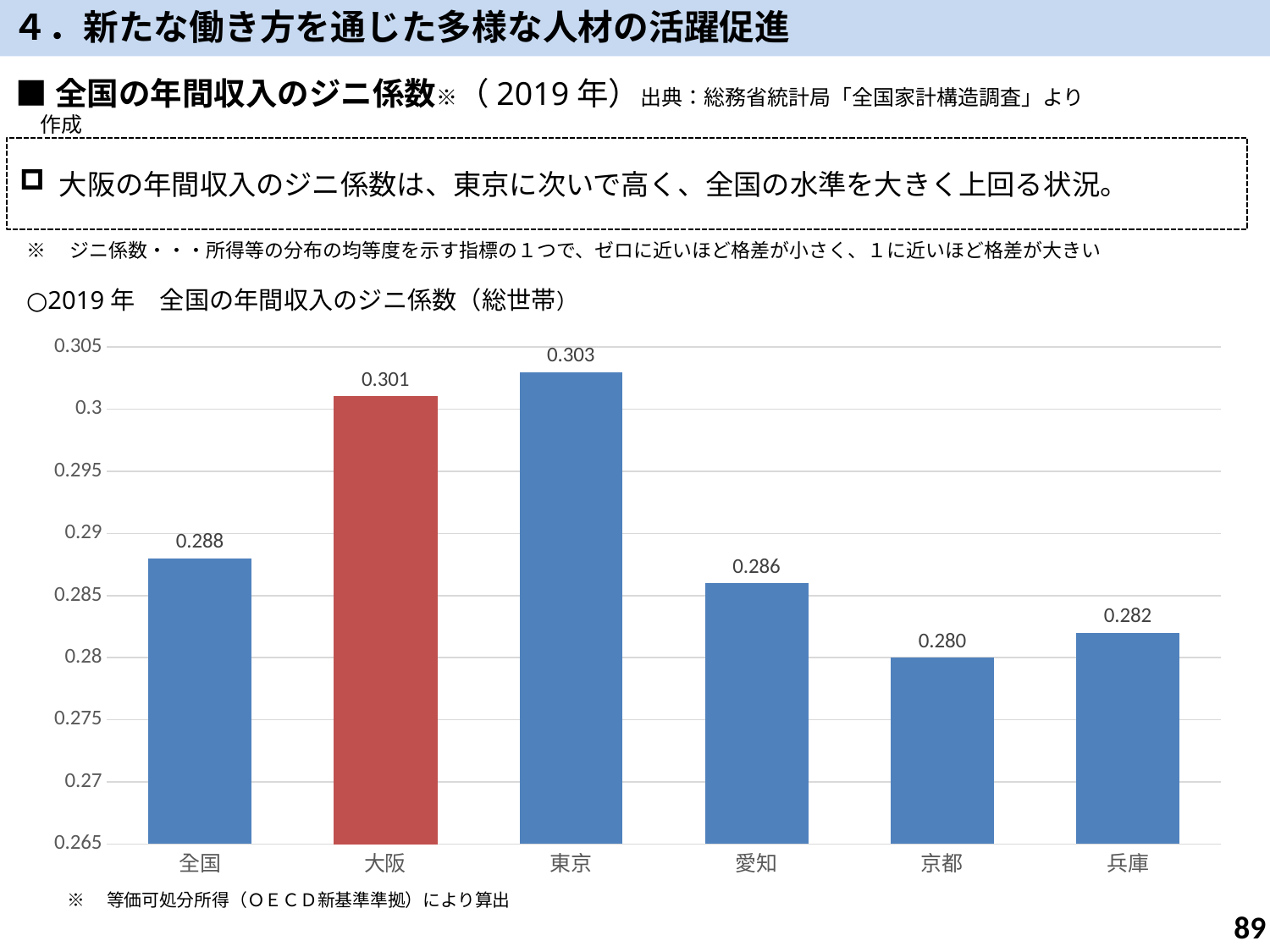
Is the value for 兵庫 greater or less than 0.285? less What is the Gini coefficient value shown for 全国? 0.288 What is the Gini coefficient value shown for 京都? 0.280 What kind of chart is shown on the slide? bar chart What is the difference between the Gini coefficient for 東京 and for 大阪? 0.002 Which bar in the chart is coloured red rather than blue? 大阪 What is the difference between the Gini coefficient for 大阪 and for 全国? 0.013 Which has a larger Gini coefficient, 愛知 or 兵庫? 愛知 Which category has the lowest Gini coefficient in the chart? 京都 What is the Gini coefficient value shown for 大阪? 0.301 Which category has the highest Gini coefficient in the chart? 東京 How many categories are shown on the x axis of the chart? 6